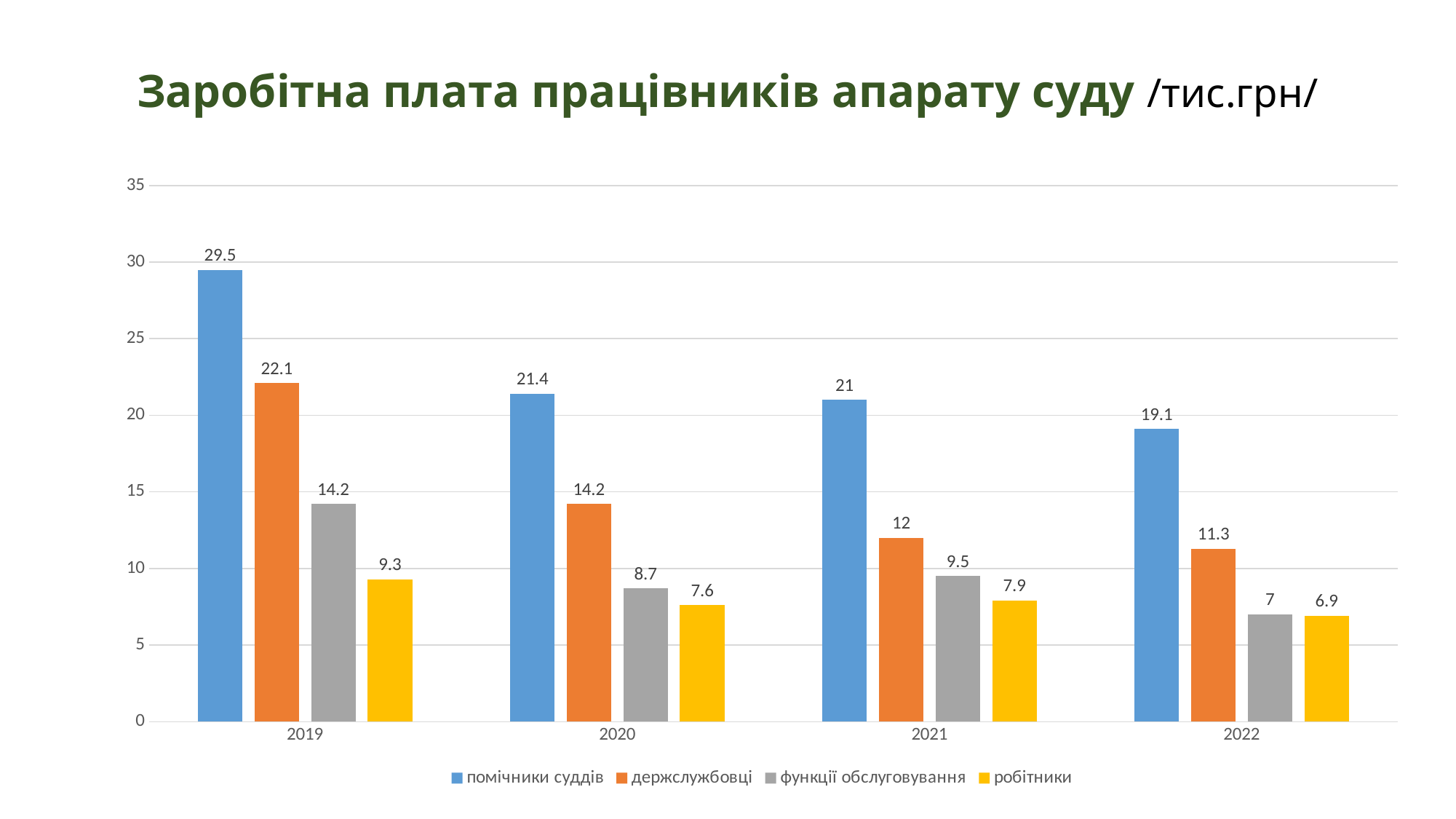
How many years are shown on the x axis? 4 What is the value for помічники суддів in 2019? 29.5 Which is larger: the value for держслужбовці in 2020 or the value for функції обслуговування in 2019? They are equal (14.2) What kind of chart is shown on the slide? Bar chart What is the value for держслужбовці in 2022? 11.3 What is the difference between the values for помічники суддів and держслужбовці in 2019? 7.4 How many series does the legend list? 4 In which year is the value for помічники суддів highest? 2019 Which is larger: the value for помічники суддів in 2021 or in 2022? 2021 In which year is the value for робітники lowest? 2022 What is the value for функції обслуговування in 2020? 8.7 What is the value for робітники in 2021? 7.9